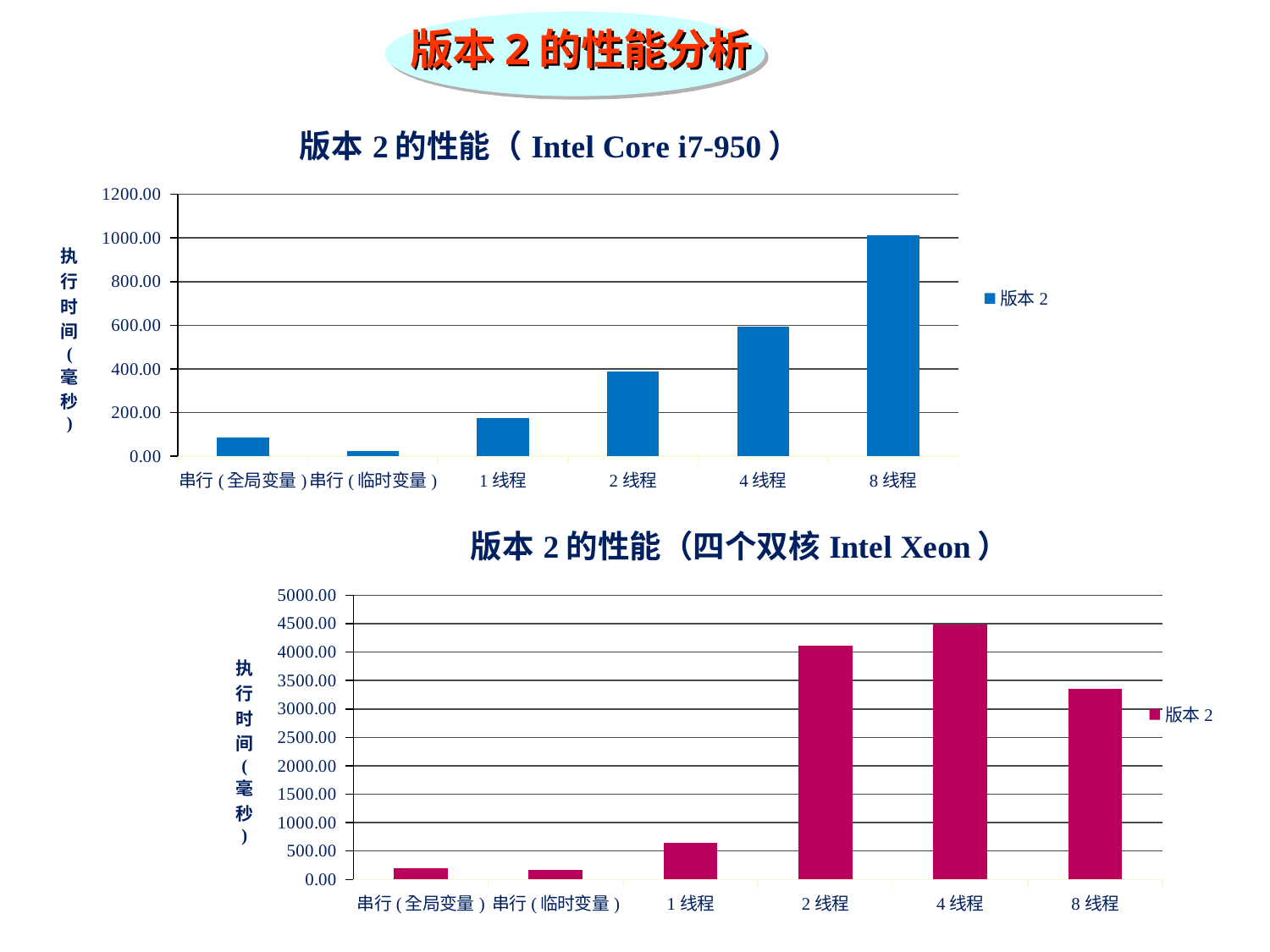
In the bottom chart (版本 2 的性能（四个双核 Intel Xeon）), what is the label of the series in the legend? 版本 2 In the bottom chart (版本 2 的性能（四个双核 Intel Xeon）), which is larger, the value for 2 线程 or the value for 8 线程? 2 线程 In the top chart (版本 2 的性能（Intel Core i7-950）), what kind of chart is shown? bar chart In the bottom chart (版本 2 的性能（四个双核 Intel Xeon）), is the value for 1 线程 greater or less than 1000.00? less In the top chart (版本 2 的性能（Intel Core i7-950）), do the values rise or fall from 1 线程 to 8 线程? rise In the top chart (版本 2 的性能（Intel Core i7-950）), which category has the highest execution time? 8 线程 In the top chart (版本 2 的性能（Intel Core i7-950）), how many categories are shown on the x axis? 6 In the bottom chart (版本 2 的性能（四个双核 Intel Xeon）), how many series does the legend list? 1 In the bottom chart (版本 2 的性能（四个双核 Intel Xeon）), which category has the highest execution time? 4 线程 In the top chart (版本 2 的性能（Intel Core i7-950）), which category has the lowest execution time? 串行 ( 临时变量 )